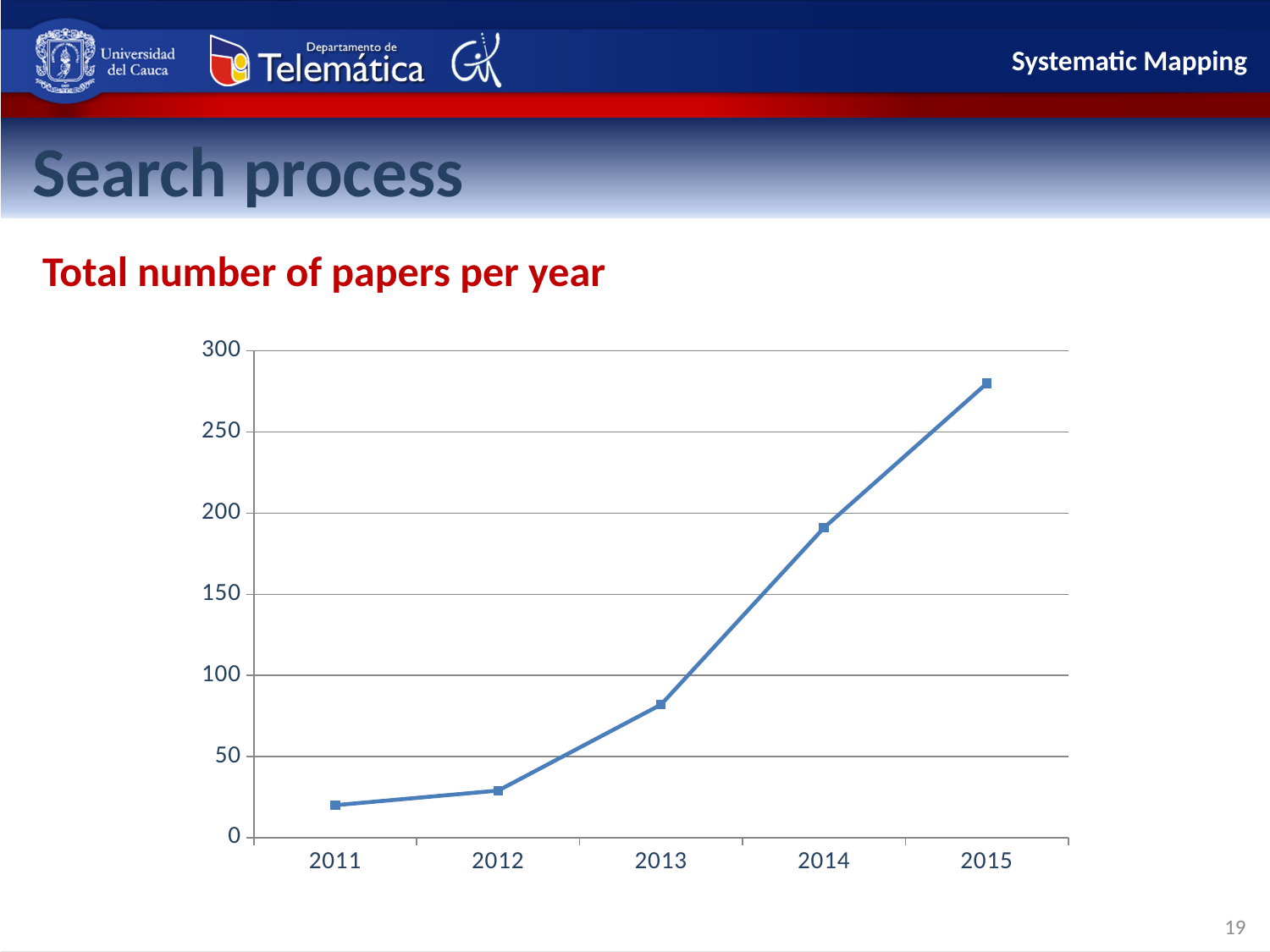
Which year has the highest number of papers in the chart? 2015 What is the maximum value shown on the y axis of the chart? 300 What kind of chart is shown on the slide? line chart Is the value for 2013 greater or less than 100? less What is the heading shown above the chart? Total number of papers per year Is the value for 2015 greater or less than 250? greater How many years are plotted on the x axis of the chart? 5 Do the values in the chart rise or fall from 2011 to 2015? rise Is the value for 2014 greater or less than 200? less Which year has a larger value, 2013 or 2014? 2014 Which year has the lowest number of papers in the chart? 2011